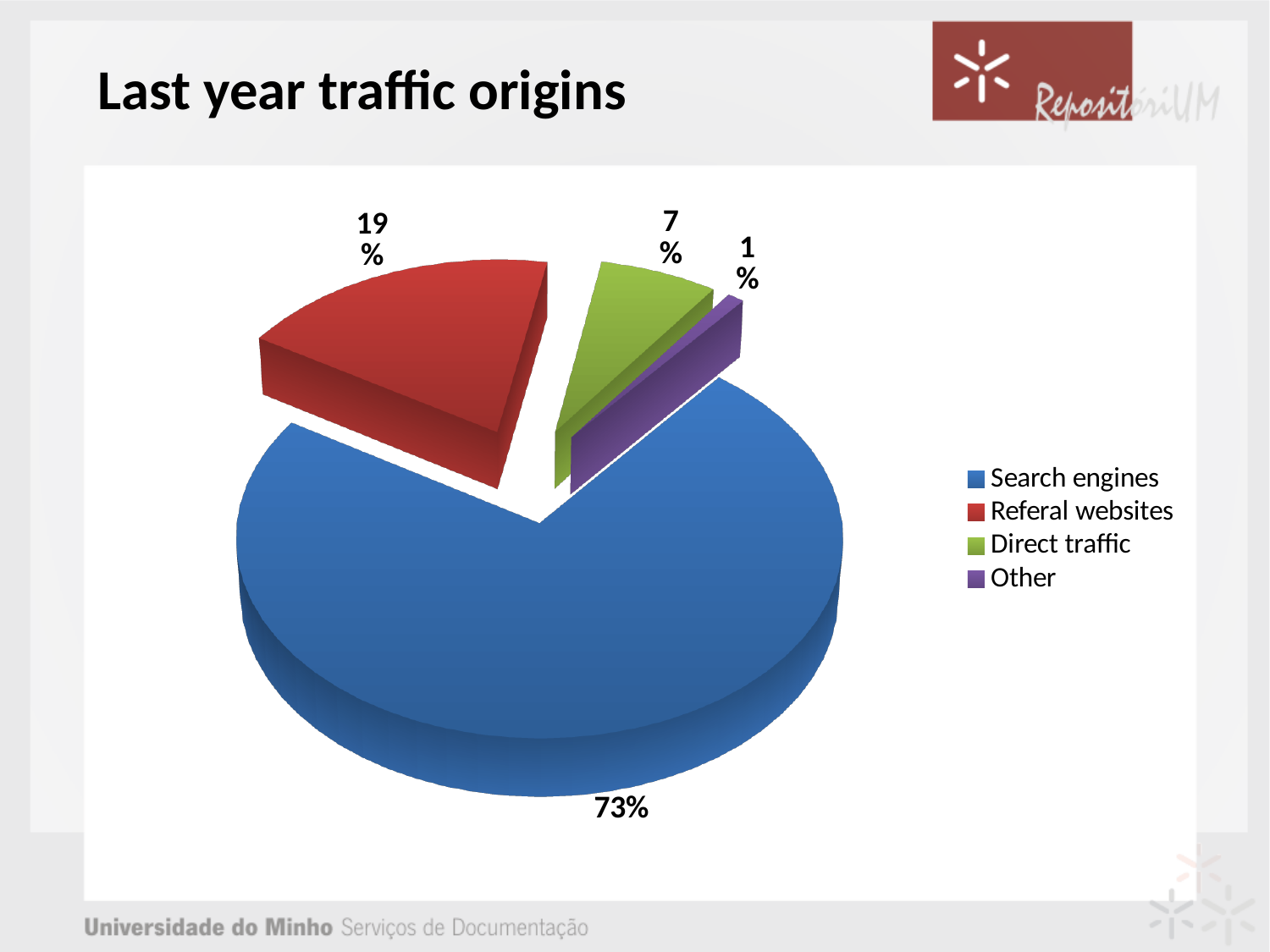
What share of traffic was direct traffic? 7% What is the title of the slide? Last year traffic origins What is the difference in percentage points between search engines and referral websites? 54 What colour is the slice for direct traffic? Green What kind of chart is shown on the slide? Pie chart How many traffic origin categories does the pie chart show? 4 What share of traffic came from referral websites? 19% What share of traffic is labelled Other? 1% Which traffic origin has the largest share? Search engines Which traffic origin has the smallest share? Other Which is larger, the share for referral websites or for direct traffic? Referral websites What share of traffic came from search engines? 73%